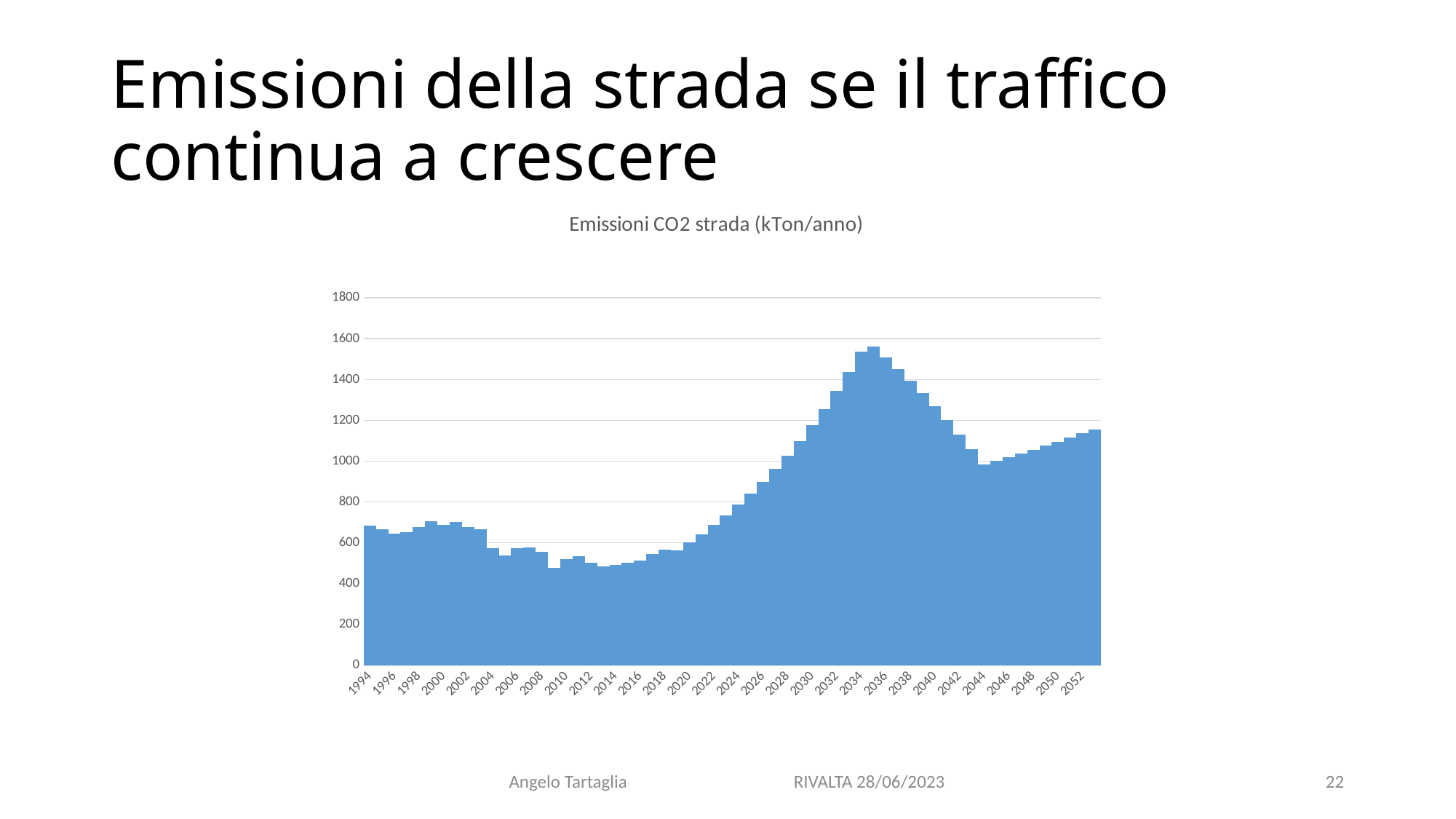
What is the title of the chart? Emissioni CO2 strada (kTon/anno) Is the value for 2052 greater or less than 1000? greater Is the value for 1994 greater or less than 600? greater Do the values rise or fall between 2014 and 2035? rise Is the value for 2030 greater or less than 1000? greater Which is larger, the value for 2000 or the value for 2010? 2000 In which year does the chart reach its highest value? 2035 Do the values rise or fall between 2035 and 2044? fall What kind of chart is shown on the slide? bar chart